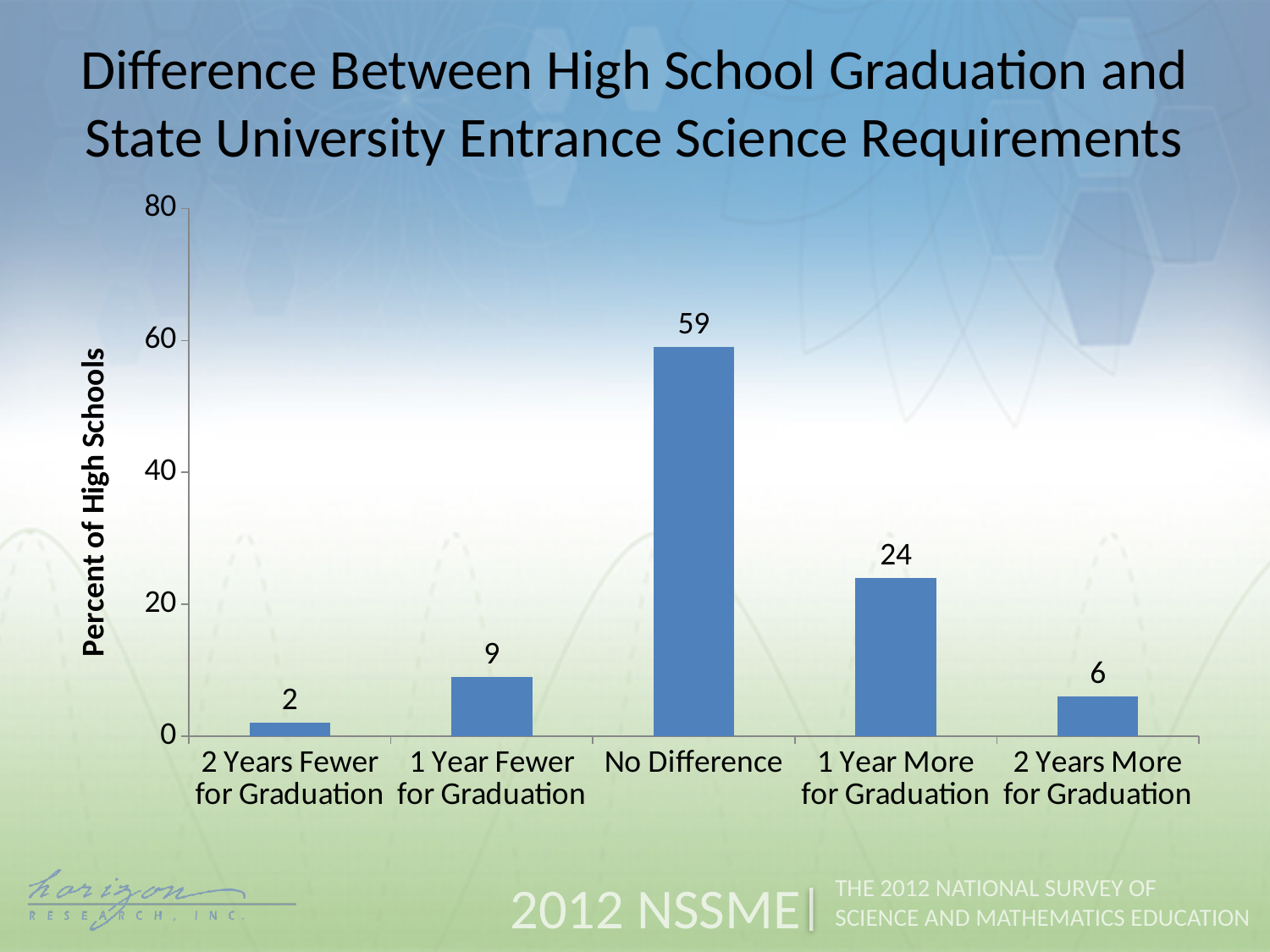
What is the label of the y axis? Percent of High Schools How many categories are shown on the x axis? 5 What kind of chart is shown on the slide? bar chart What is the value for '1 Year Fewer for Graduation'? 9 Which category has the lowest percent of high schools? 2 Years Fewer for Graduation What is the value for '1 Year More for Graduation'? 24 Which is larger: the value for '1 Year Fewer for Graduation' or '2 Years More for Graduation'? 1 Year Fewer for Graduation What is the value for '2 Years Fewer for Graduation'? 2 What percent of high schools have no difference between graduation and state university entrance science requirements? 59 Is the value for '1 Year More for Graduation' greater or less than 20? greater Which category has the highest percent of high schools? No Difference What is the difference between the values for 'No Difference' and '1 Year More for Graduation'? 35